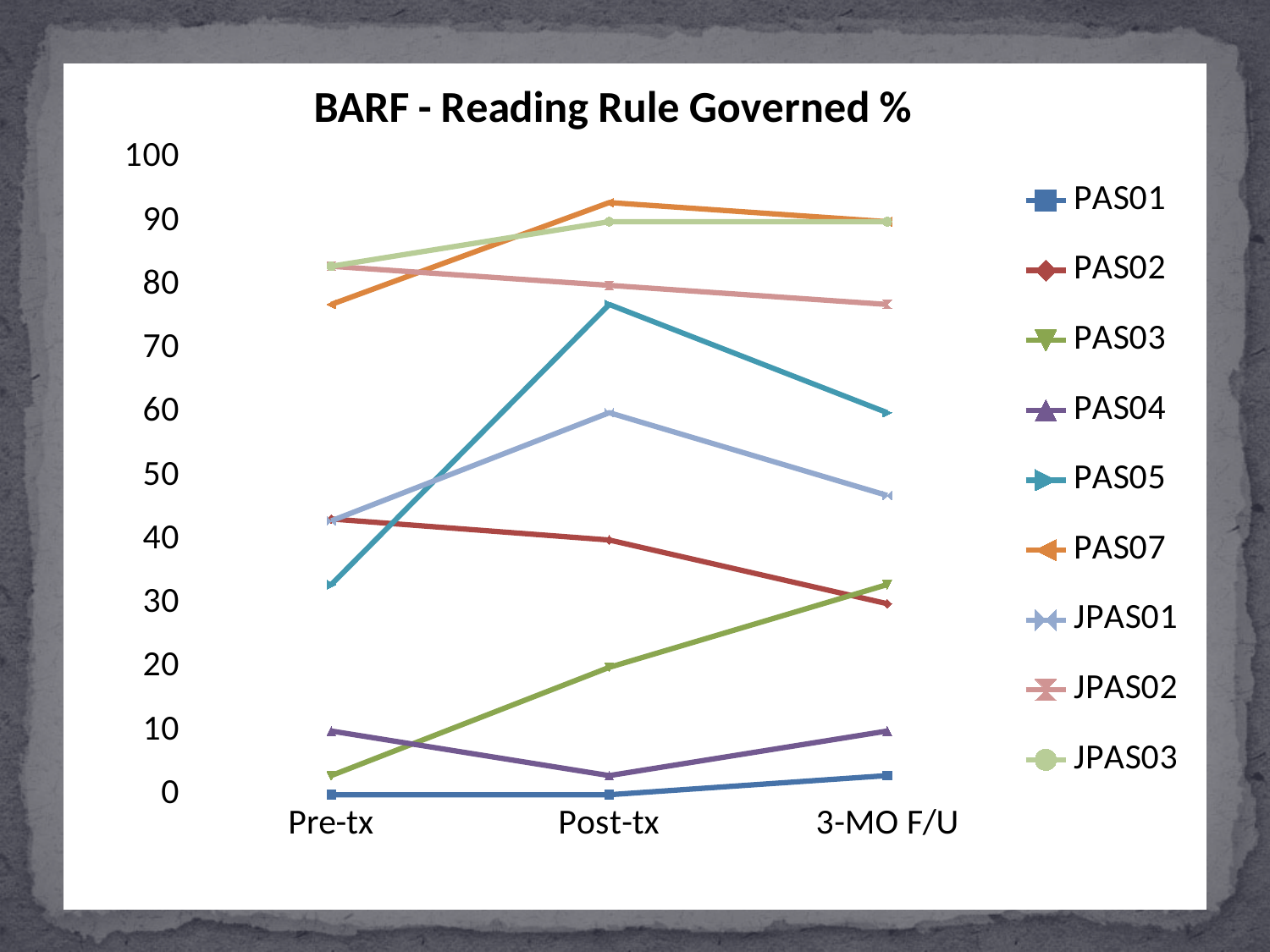
Is the value for PAS07 at Pre-tx greater or less than 70? greater What kind of chart is shown on the slide? line chart How many series does the legend list? 9 Does the PAS03 line rise or fall from Pre-tx to 3-MO F/U? rise At Post-tx, which is larger, PAS07 or PAS02? PAS07 How many time points are shown on the x axis? 3 Which series has the lowest value at Pre-tx? PAS01 Is the value for PAS03 at Pre-tx greater or less than 10? less Is the value for PAS05 at Post-tx greater or less than 70? greater Does the PAS02 line rise or fall from Pre-tx to 3-MO F/U? fall What is the title of the chart? BARF - Reading Rule Governed %